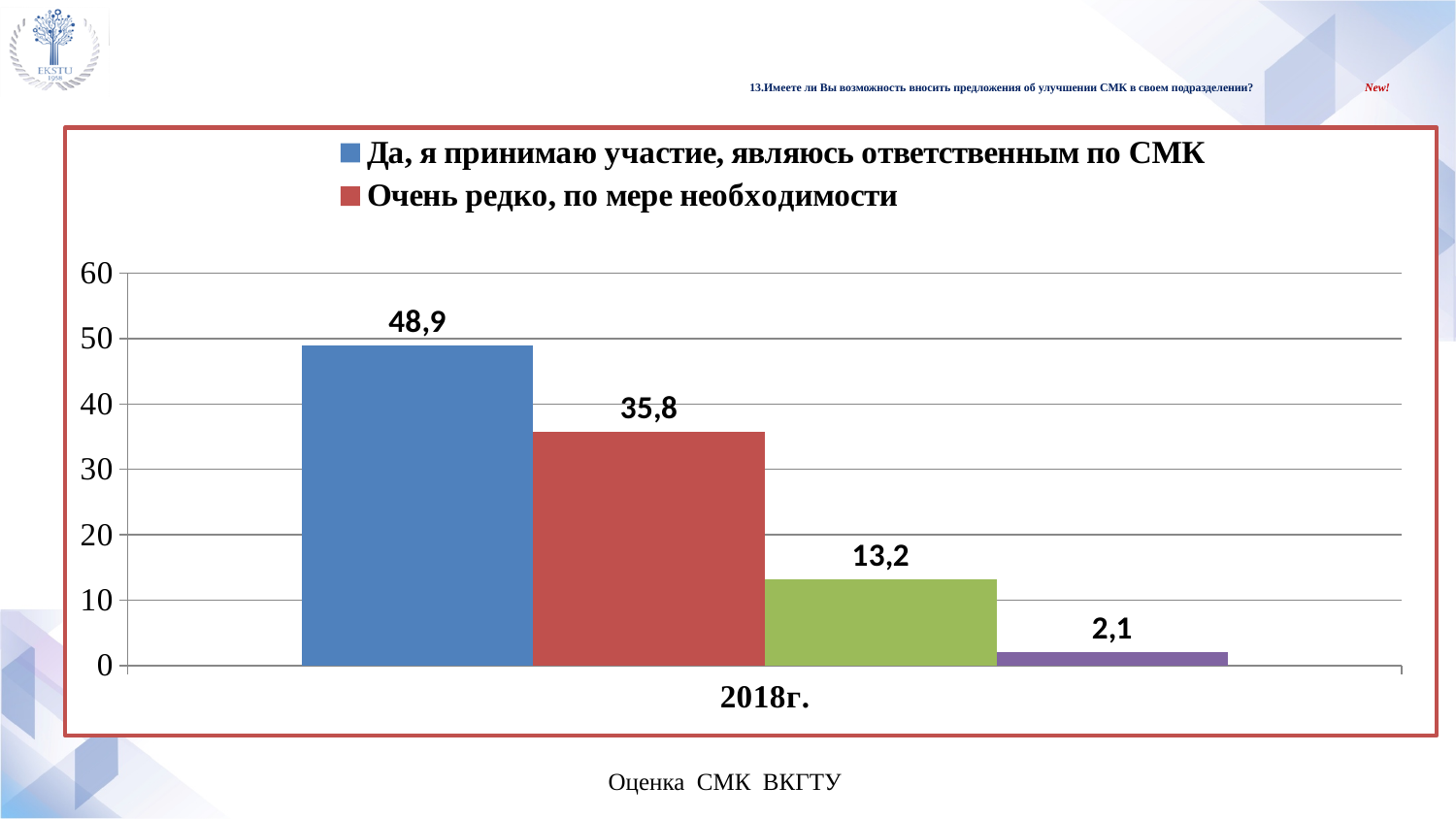
Which is larger: the value for "Очень редко, по мере необходимости" or the value on the green bar? Очень редко, по мере необходимости How many series does the legend list? 2 What is the smallest value shown on the chart? 2,1 What is the value shown on the purple bar? 2,1 Which series has the highest value? Да, я принимаю участие, являюсь ответственным по СМК What is the value for "Да, я принимаю участие, являюсь ответственным по СМК" in 2018г.? 48,9 How many bars are plotted on the chart? 4 What is the difference between the values for "Да, я принимаю участие, являюсь ответственным по СМК" and "Очень редко, по мере необходимости"? 13,1 What is the value shown on the green bar? 13,2 What is the value for "Очень редко, по мере необходимости" in 2018г.? 35,8 Is the value for "Да, я принимаю участие, являюсь ответственным по СМК" greater or less than 40? greater What kind of chart is shown on the slide? bar chart